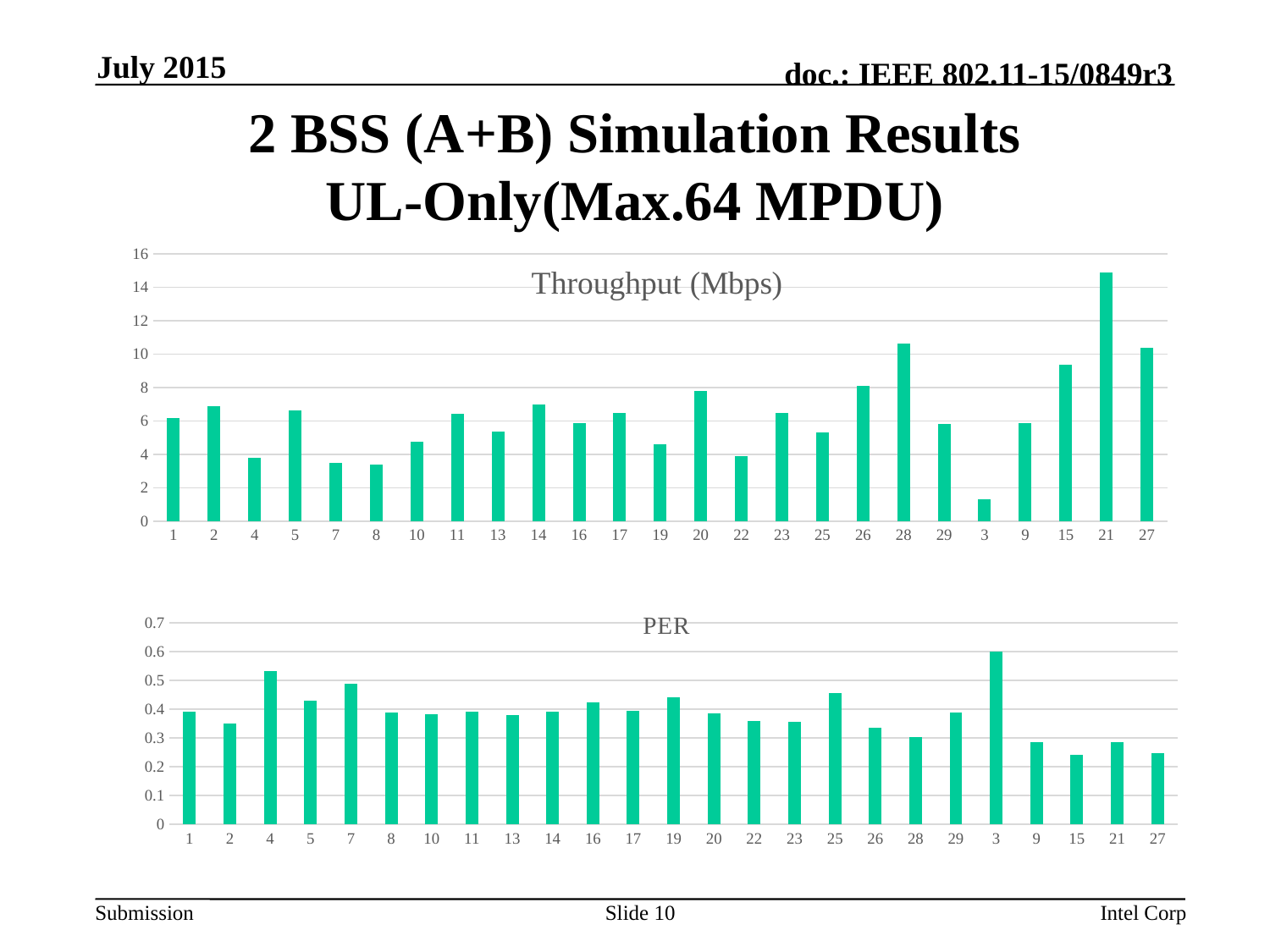
In the Throughput (Mbps) chart, is the value for category 28 greater or less than 10? greater In the Throughput (Mbps) chart, which is larger, the value for category 2 or category 4? 2 How many categories are plotted in the Throughput (Mbps) chart? 25 In the PER chart, is the value for category 15 greater or less than 0.3? less In the PER chart, is the value for category 4 greater or less than 0.5? greater What kind of chart is the Throughput (Mbps) chart? bar chart In the PER chart, which is larger, the value for category 4 or category 2? 4 In the Throughput (Mbps) chart, which category has the lowest throughput? 3 In the PER chart, which category has the highest PER? 3 What is the title of the lower chart on the slide? PER In the Throughput (Mbps) chart, which category has the highest throughput? 21